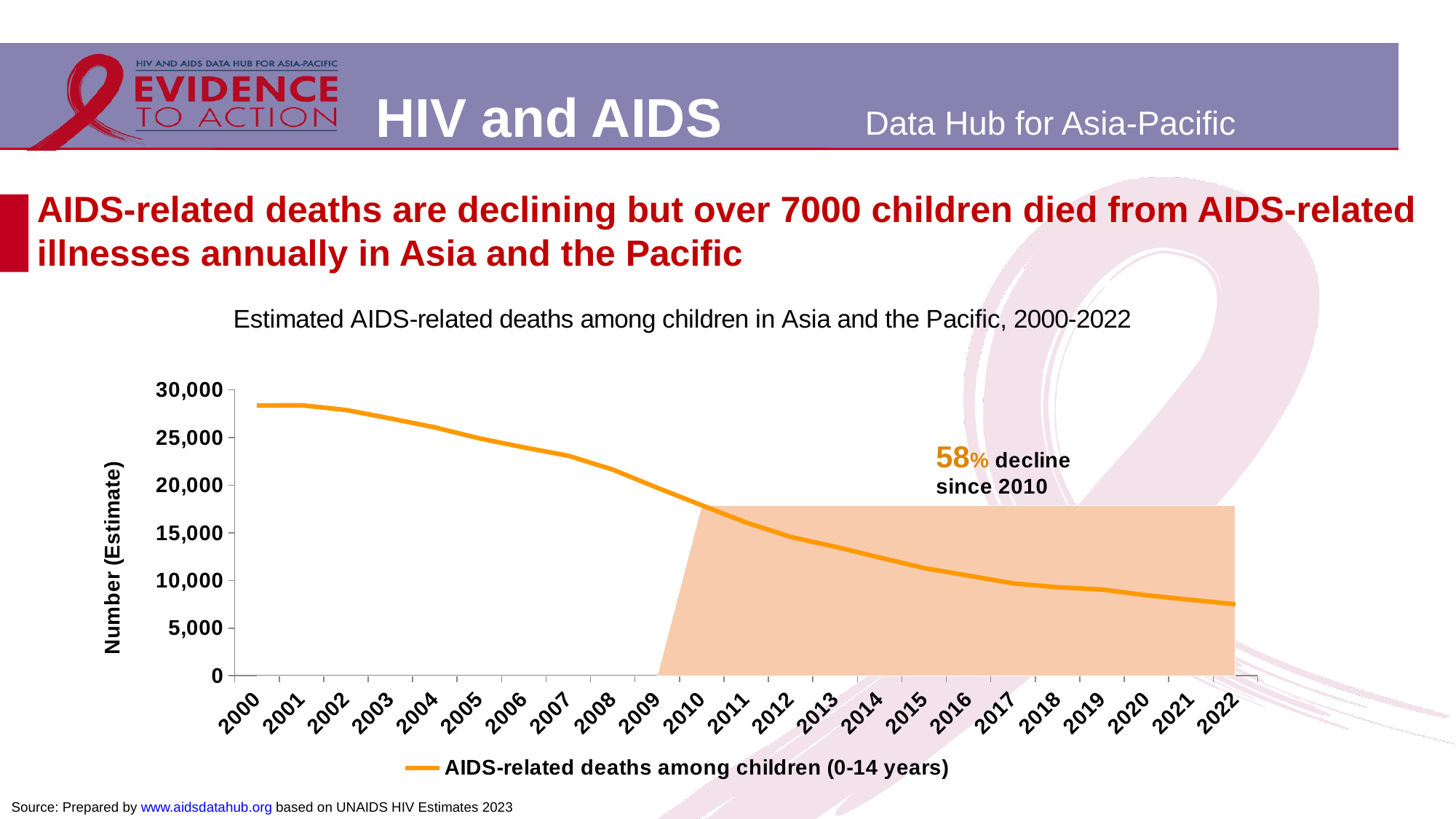
What is the label of the series in the legend? AIDS-related deaths among children (0-14 years) Is the value for 2015 greater or less than 10,000? greater Which is larger, the value for 2005 or the value for 2015? 2005 Is the value for 2022 greater or less than 10,000? less How many years are shown on the x axis? 23 What kind of chart is shown on the slide? line chart Is the value for 2010 greater or less than 20,000? less What is the title of the chart? Estimated AIDS-related deaths among children in Asia and the Pacific, 2000-2022 Which year has the lowest value? 2022 How many series does the legend list? 1 Do the values rise or fall from 2000 to 2022? fall